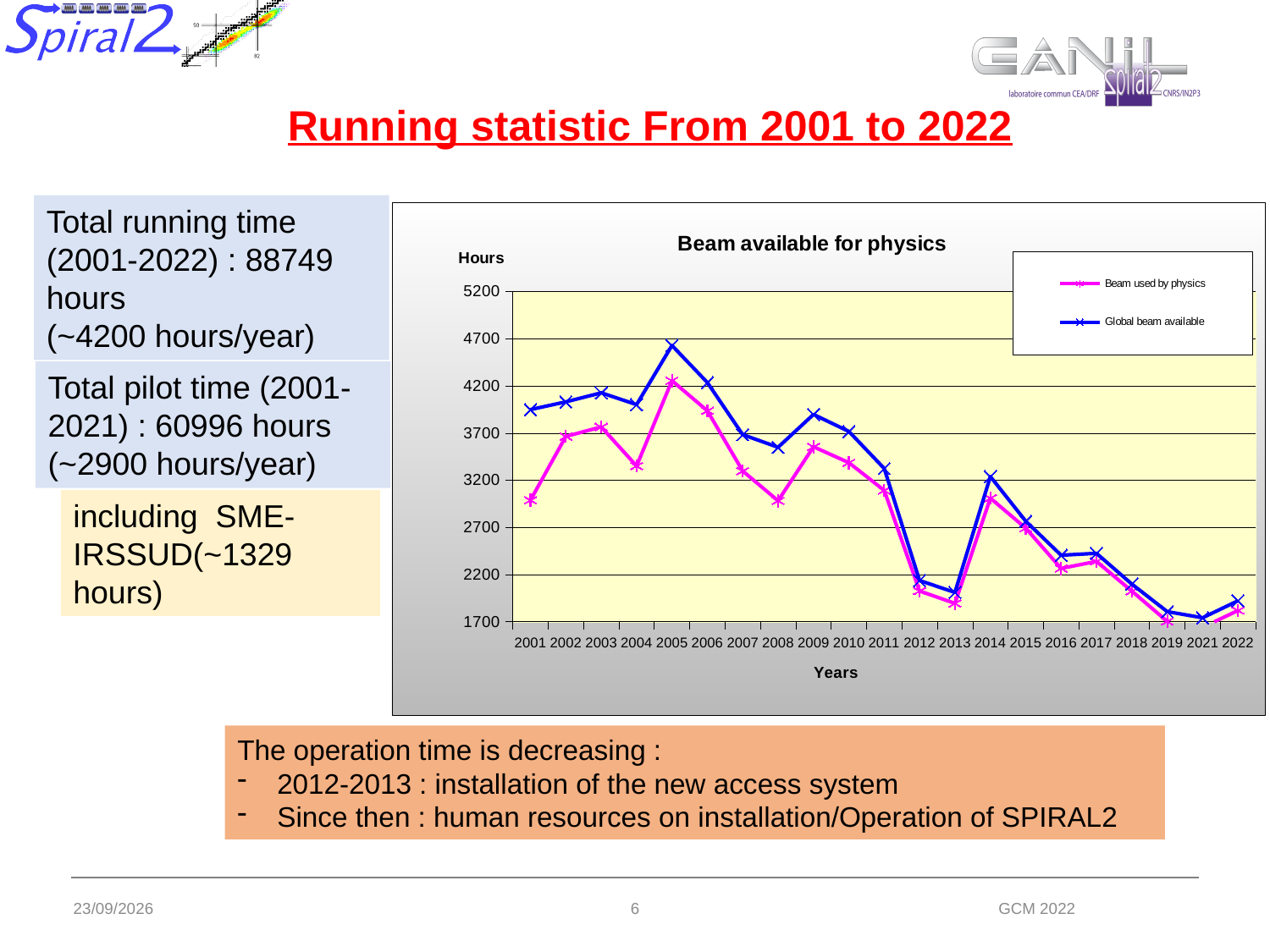
In 2009, which series has the higher value: Beam used by physics or Global beam available? Global beam available Is the Beam used by physics value for 2001 greater or less than 3200? less Is the Global beam available value for 2005 greater or less than 4200? greater What kind of chart is shown on the slide? line chart Is the Beam used by physics value for 2019 greater or less than 2200? less Overall, do the values of the Global beam available series rise or fall from 2001 to 2022? fall What is the title of the chart? Beam available for physics How many series does the chart legend list? 2 How many years are plotted along the x axis of the chart? 21 In which year does the Global beam available series reach its highest value? 2005